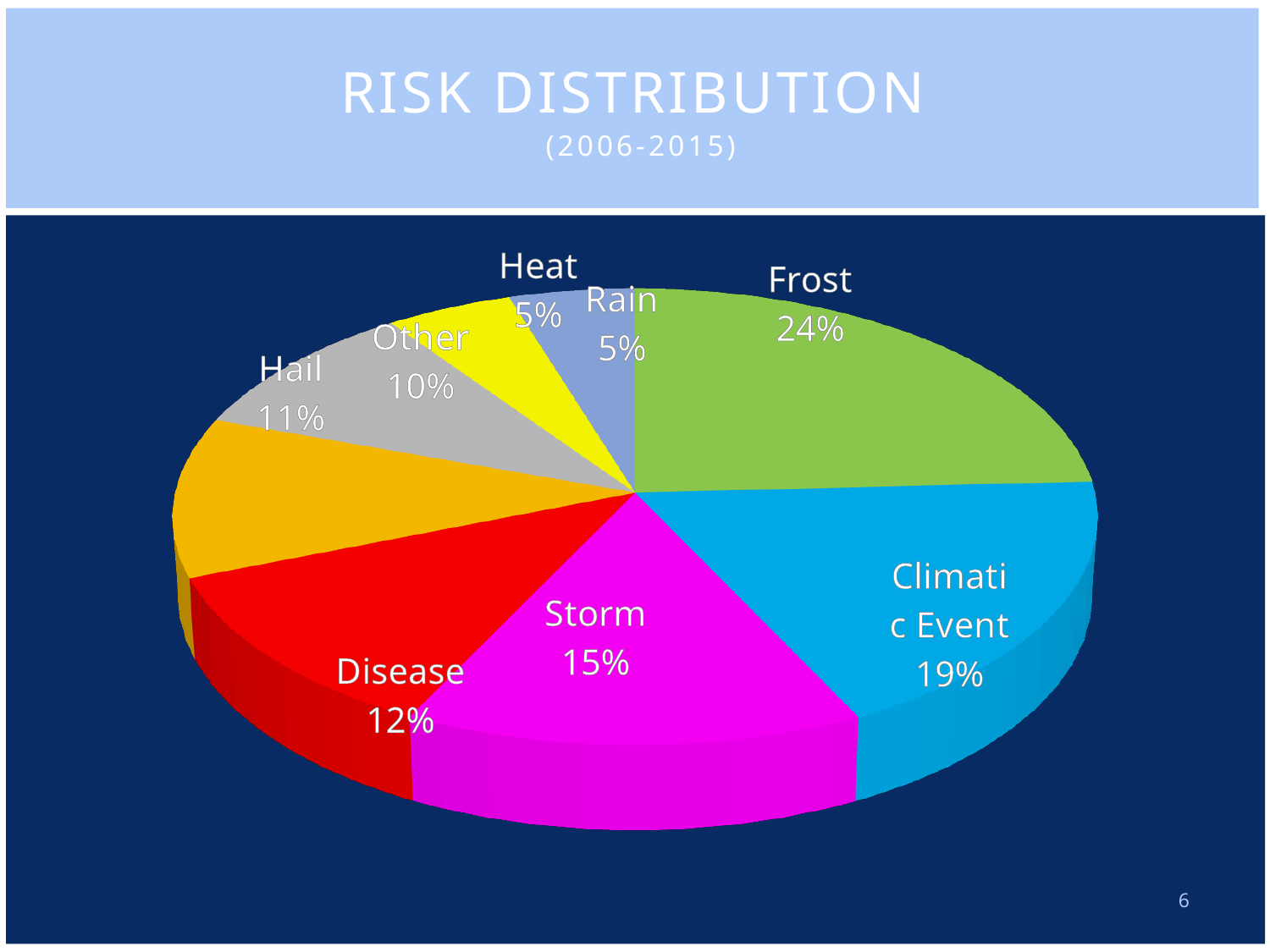
Which category has the largest slice of the pie? Frost What share of the pie does Frost account for? 24% What is the difference between the Frost and Climatic Event shares? 5 percentage points What is the value for Storm? 15% What is the value for Disease? 12% What kind of chart is shown on the slide? pie chart What is the value for Other? 10% Which is larger, the share for Storm or the share for Disease? Storm How many slices does the pie chart have? 8 What is the value for Climatic Event? 19% What is the value for Hail? 11% What period does the chart title say the risk distribution covers? 2006-2015